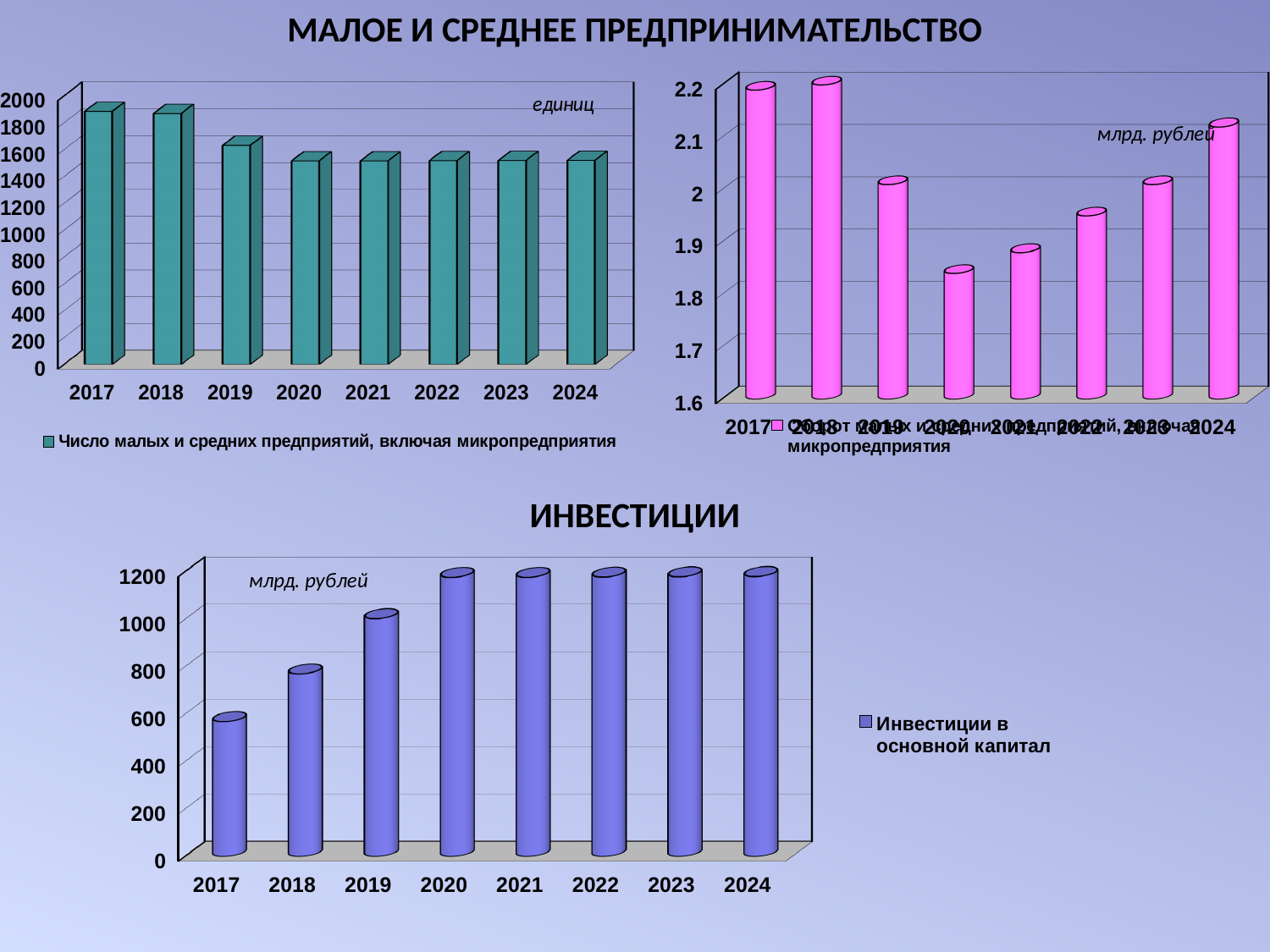
In the ИНВЕСТИЦИИ chart, is the value for 2020 greater or less than 1000? greater In the ИНВЕСТИЦИИ chart, which year has the lowest value? 2017 In the top-left chart (Число малых и средних предприятий), is the value for 2020 greater or less than 1600? less In the top-right chart (млрд. рублей, pink bars), which is larger, the value for 2017 or the value for 2020? 2017 How many years are shown on the x axis of the top-left chart (Число малых и средних предприятий)? 8 In the ИНВЕСТИЦИИ chart, do the values generally rise or fall from 2017 to 2024? rise In the top-left chart (Число малых и средних предприятий), is the value for 2017 greater or less than 1800? greater In the top-left chart (Число малых и средних предприятий), do the values generally rise or fall from 2017 to 2024? fall What kind of chart is the top-left chart (Число малых и средних предприятий)? bar chart What series name does the legend of the ИНВЕСТИЦИИ chart show? Инвестиции в основной капитал In the top-right chart (млрд. рублей, pink bars), which year has the lowest value? 2020